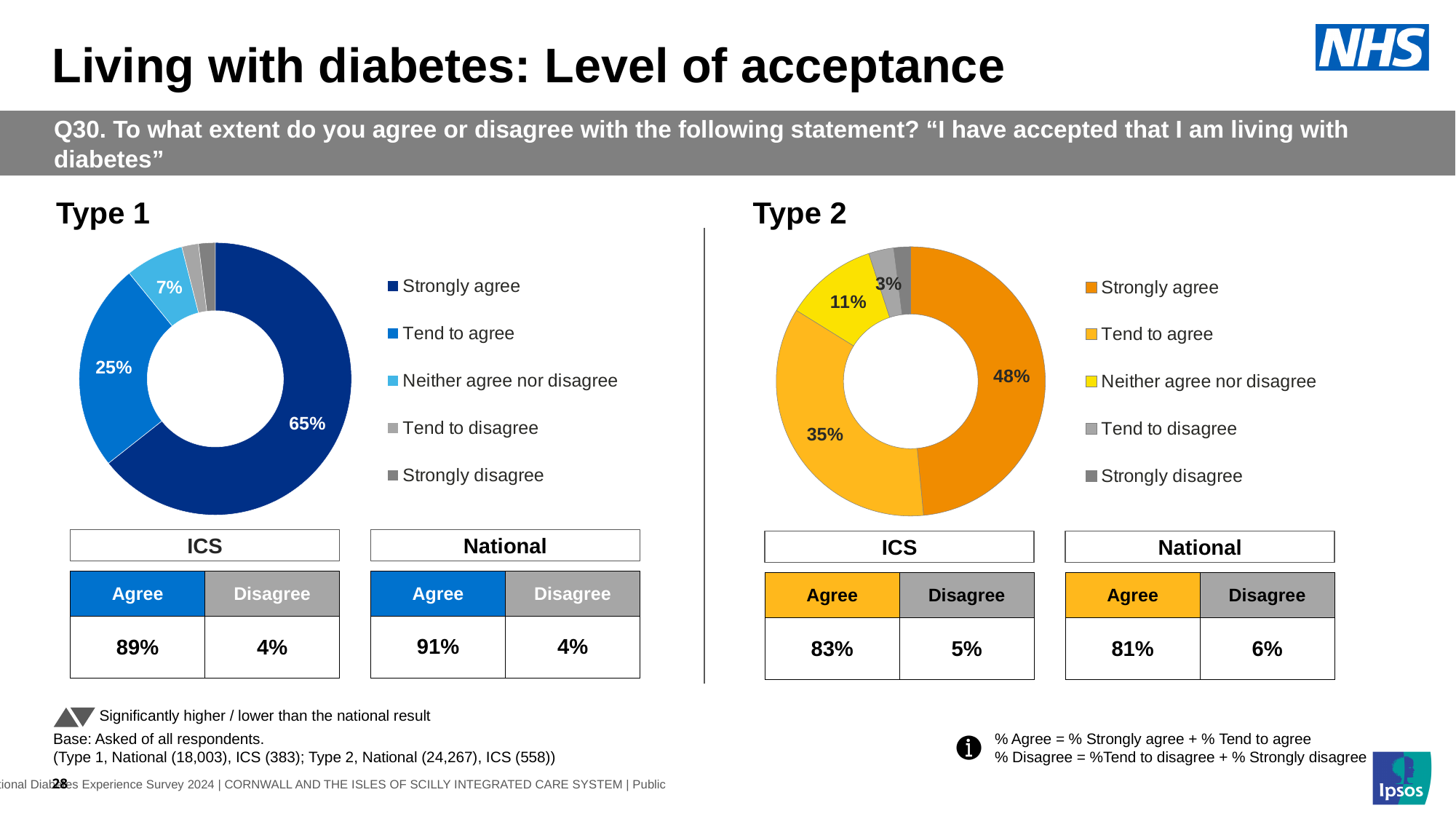
In the Type 1 chart, what percentage of respondents strongly agree? 65% In the Type 2 chart, which response category has the largest share? Strongly agree In the Type 1 chart, what percentage neither agree nor disagree? 7% In the Type 1 chart, what is the difference in percentage points between Strongly agree and Tend to agree? 40 In the Type 1 chart, what percentage of respondents tend to agree? 25% In the Type 2 chart, what percentage of respondents strongly agree? 48% In the Type 2 chart, what percentage neither agree nor disagree? 11% How many response categories does the legend of the Type 2 chart list? 5 What kind of chart is used for Type 1? Donut (pie) chart In the Type 1 chart, which response category has the largest share? Strongly agree In the Type 2 chart, what percentage of respondents tend to agree? 35% Which chart has a larger Strongly agree share, Type 1 or Type 2? Type 1